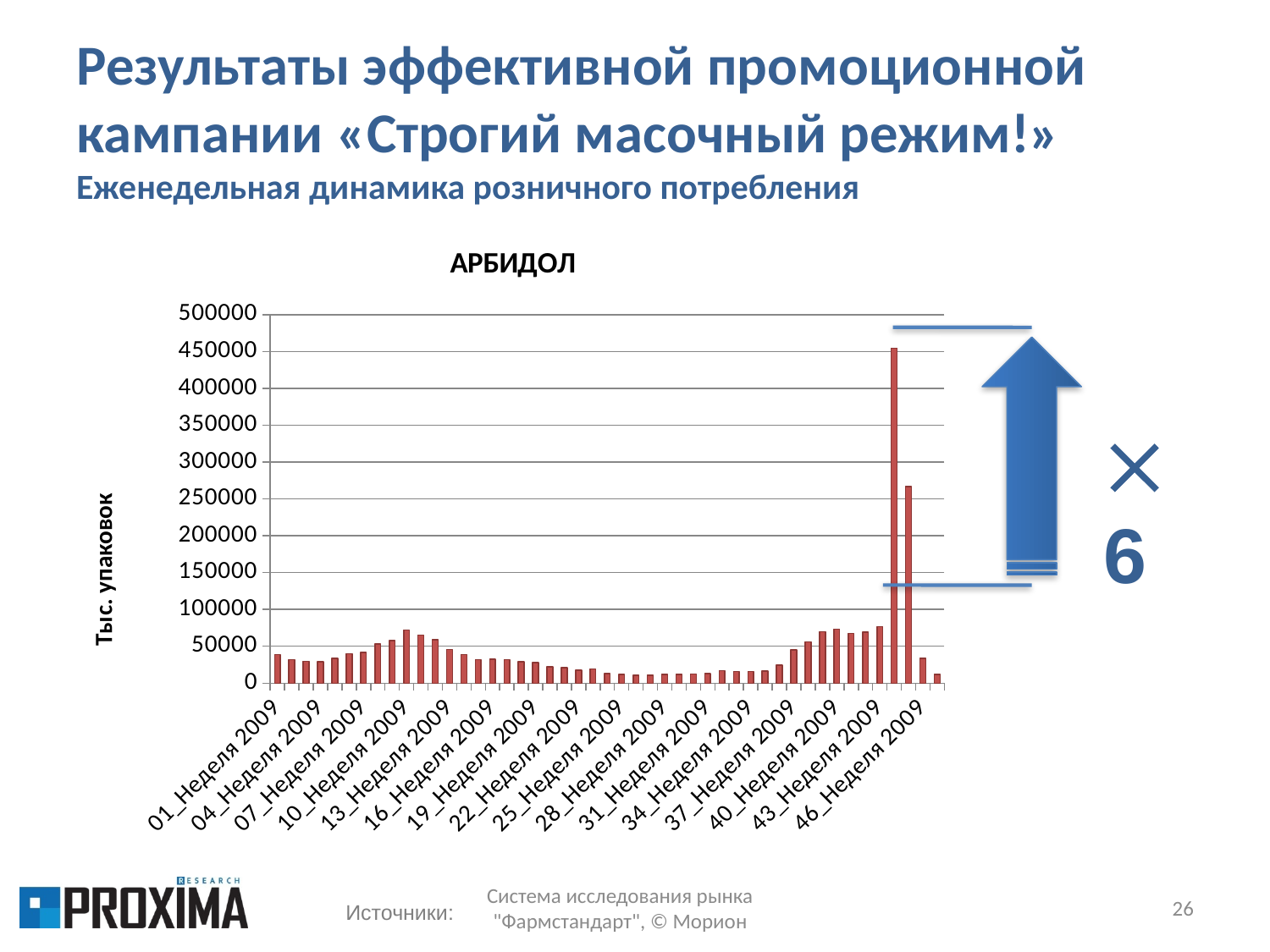
Between 01_Неделя 2009 and 10_Неделя 2009, do the values generally rise or fall? rise What is the highest value shown on the vertical axis of the chart? 500000 Which has the larger value, 01_Неделя 2009 or 10_Неделя 2009? 10_Неделя 2009 What is the title of the chart? АРБИДОЛ Is the value of the second tallest bar in the chart greater or less than 300000? less Is the value of the tallest bar in the chart greater or less than 400000? greater Is the value for 01_Неделя 2009 greater or less than 50000? less What kind of chart is shown on the slide? bar chart Between 10_Неделя 2009 and 28_Неделя 2009, do the values generally rise or fall? fall What is the label on the vertical axis of the chart? Тыс. упаковок